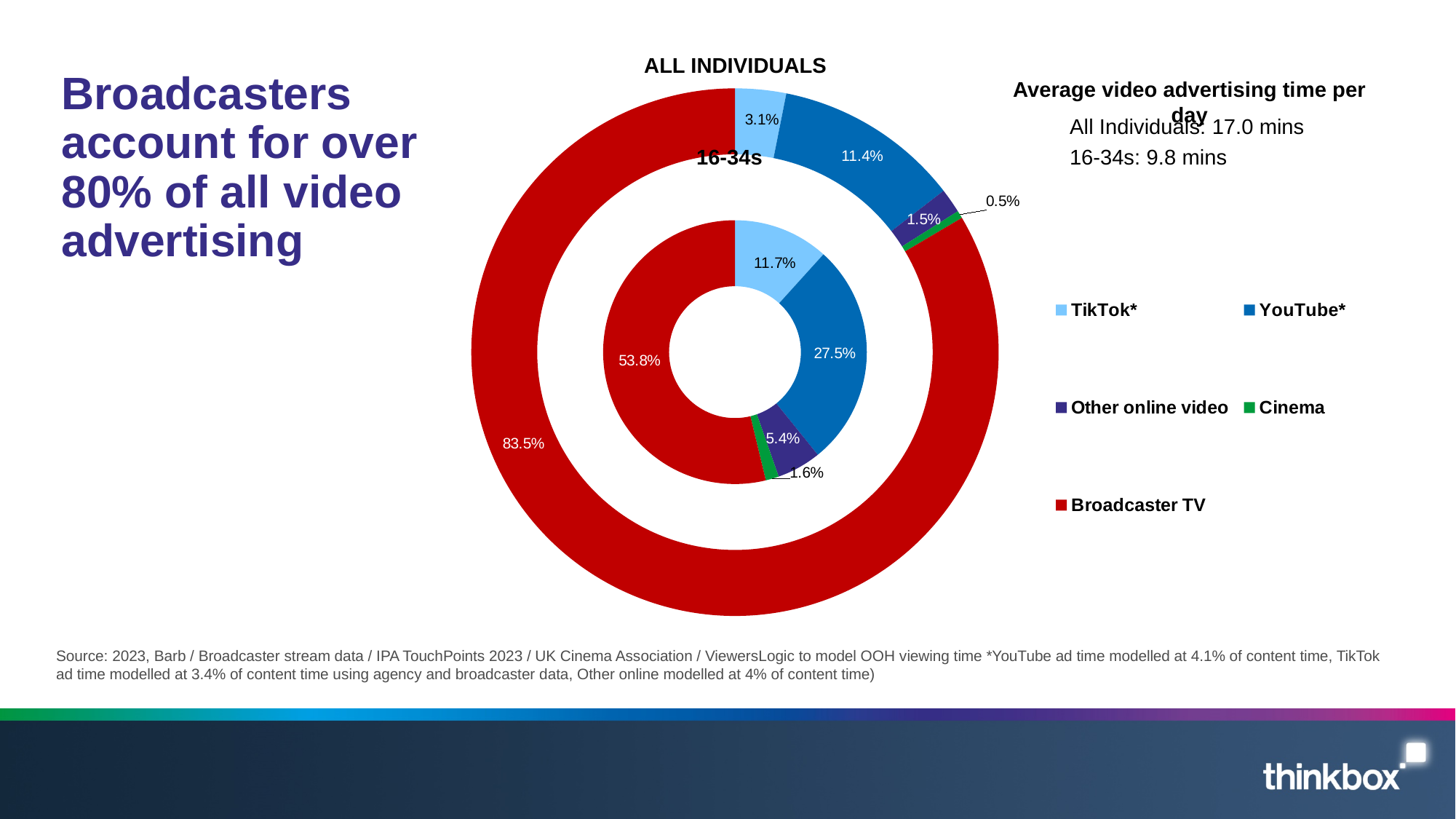
What share of video advertising time does Broadcaster TV account for in the ALL INDIVIDUALS ring? 83.5% Which is larger: the TikTok* share for 16-34s or the YouTube* share for ALL INDIVIDUALS? TikTok* share for 16-34s What is the TikTok* share in the ALL INDIVIDUALS ring? 3.1% How many categories does the legend list? 5 What share of video advertising time does YouTube* account for in the 16-34s ring? 27.5% Which category has the smallest share in the ALL INDIVIDUALS ring? Cinema What is the difference between the Broadcaster TV share for ALL INDIVIDUALS and for 16-34s? 29.7 percentage points How many rings (series) does the doughnut chart show? 2 What type of chart is shown on the slide? Doughnut chart What is the Cinema share in the 16-34s ring? 1.6% What colour represents Broadcaster TV in the chart? Red Which category has the largest share in the 16-34s ring? Broadcaster TV